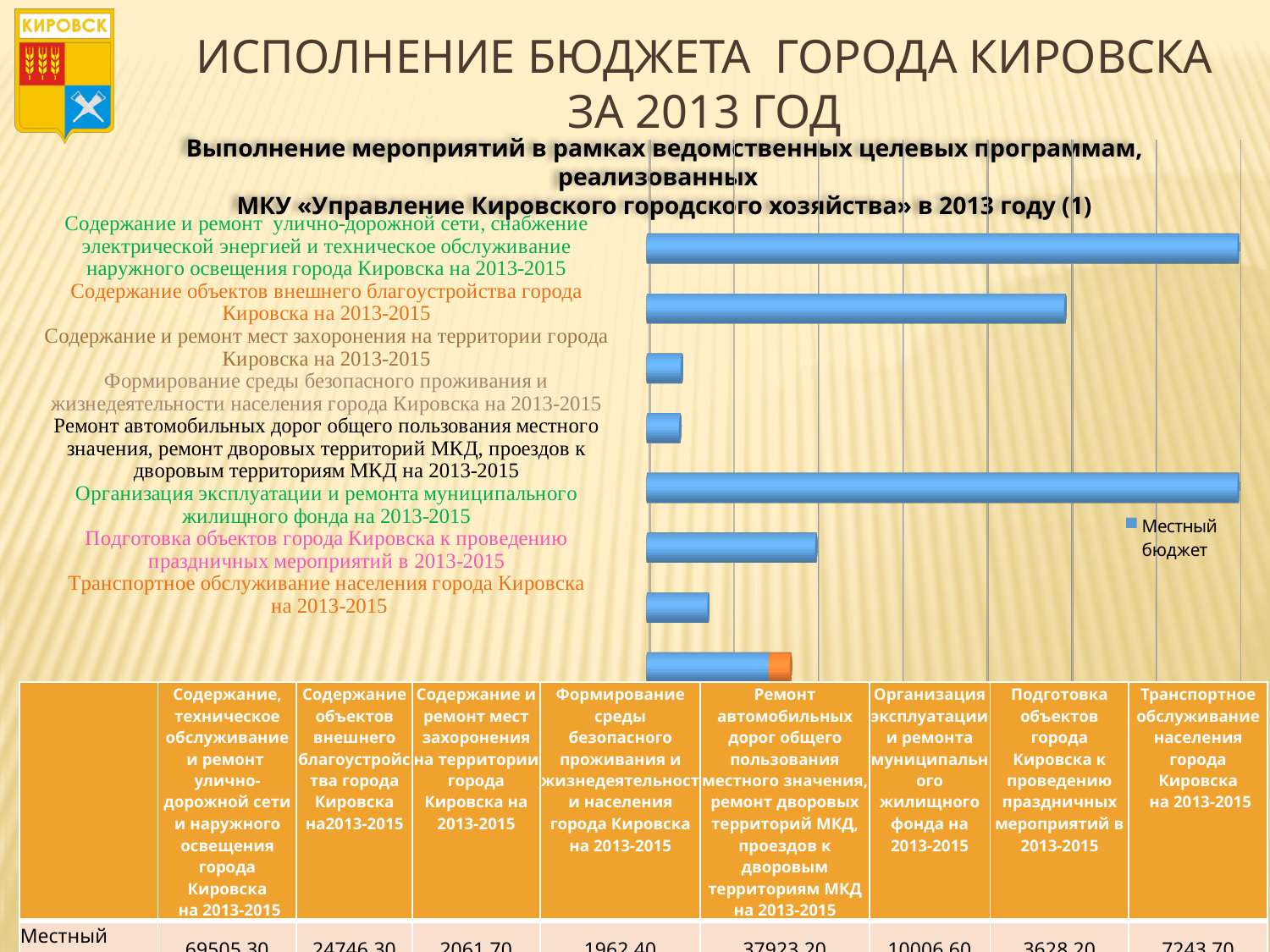
What is the name of the series shown in the chart legend? Местный бюджет According to the data table, what is the value for «Транспортное обслуживание населения города Кировска на 2013-2015»? 7243,70 How many categories (programmes) are plotted in the chart? 8 According to the data table, what is the value for «Организация эксплуатации и ремонта муниципального жилищного фонда на 2013-2015»? 10006,60 What kind of chart is shown on the slide? bar chart Which is larger: the value for «Транспортное обслуживание населения города Кировска на 2013-2015» or for «Формирование среды безопасного проживания и жизнедеятельности населения города Кировска на 2013-2015»? Транспортное обслуживание населения города Кировска на 2013-2015 What is the title of the chart? Выполнение мероприятий в рамках ведомственных целевых программам, реализованных МКУ «Управление Кировского городского хозяйства» в 2013 году (1) Which is larger: the value for «Организация эксплуатации и ремонта муниципального жилищного фонда на 2013-2015» or for «Подготовка объектов города Кировска к проведению праздничных мероприятий в 2013-2015»? Организация эксплуатации и ремонта муниципального жилищного фонда на 2013-2015 According to the data table, what is the value for «Содержание объектов внешнего благоустройства города Кировска на 2013-2015»? 24746,30 Which is larger: the value for «Содержание объектов внешнего благоустройства города Кировска на 2013-2015» or for «Содержание и ремонт мест захоронения на территории города Кировска на 2013-2015»? Содержание объектов внешнего благоустройства города Кировска на 2013-2015 How many series does the chart legend list? 1